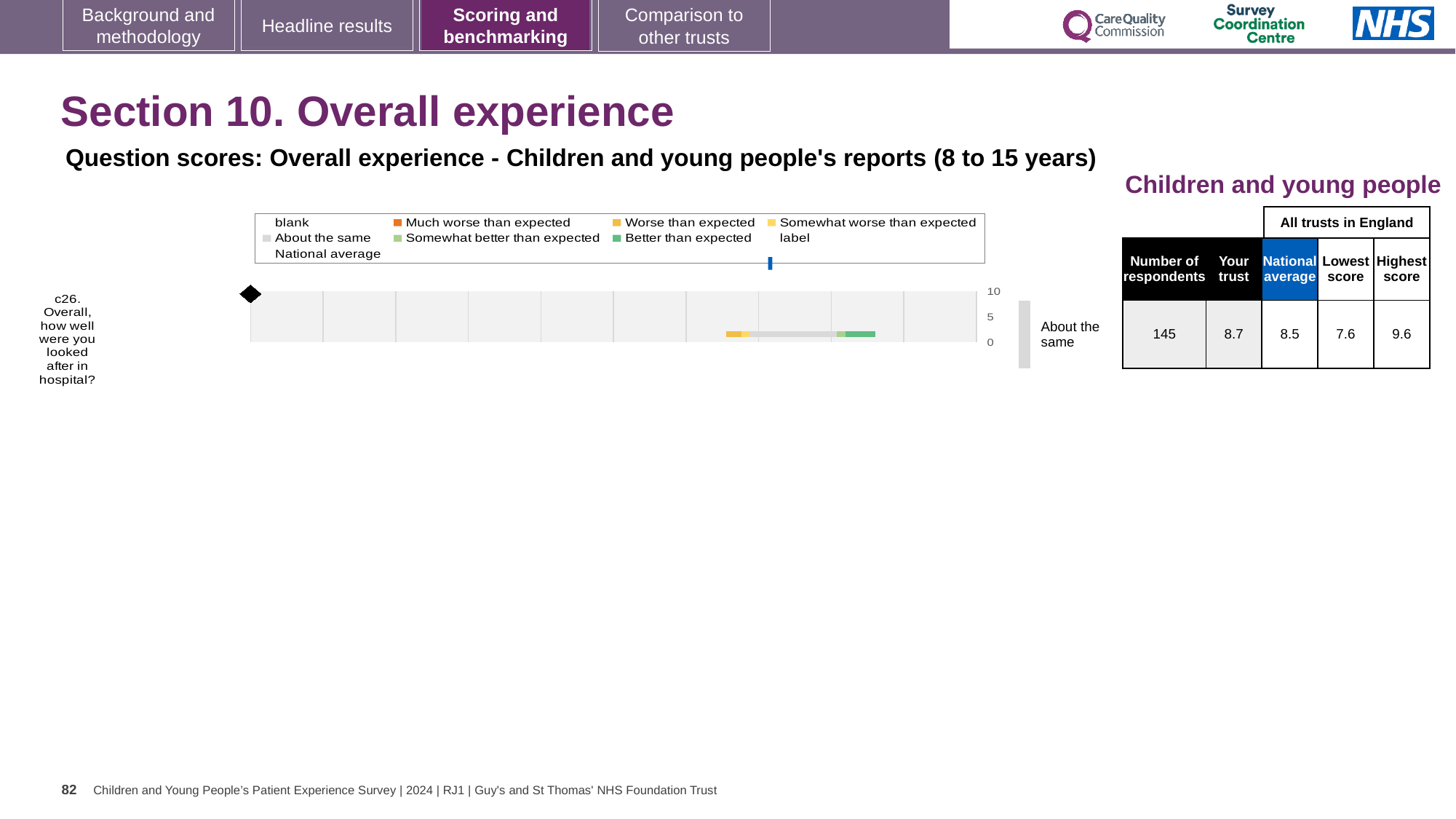
Which is larger for question c26, the 'Your trust' score or the national average? Your trust What is the question number of the item plotted in the chart? c26 What is the highest score among all trusts in England for question c26? 9.6 What is the highest value shown on the chart's score axis? 10 What kind of chart is shown on the slide? bar chart What is the lowest score among all trusts in England for question c26? 7.6 How many questions (categories) are plotted in the chart? 1 What is the national average score for question c26? 8.5 How many respondents answered question c26? 145 What is the 'Your trust' score for question c26? 8.7 What is the benchmark result shown next to the bar for question c26? About the same What is the difference between the 'Your trust' score and the national average for question c26? 0.2